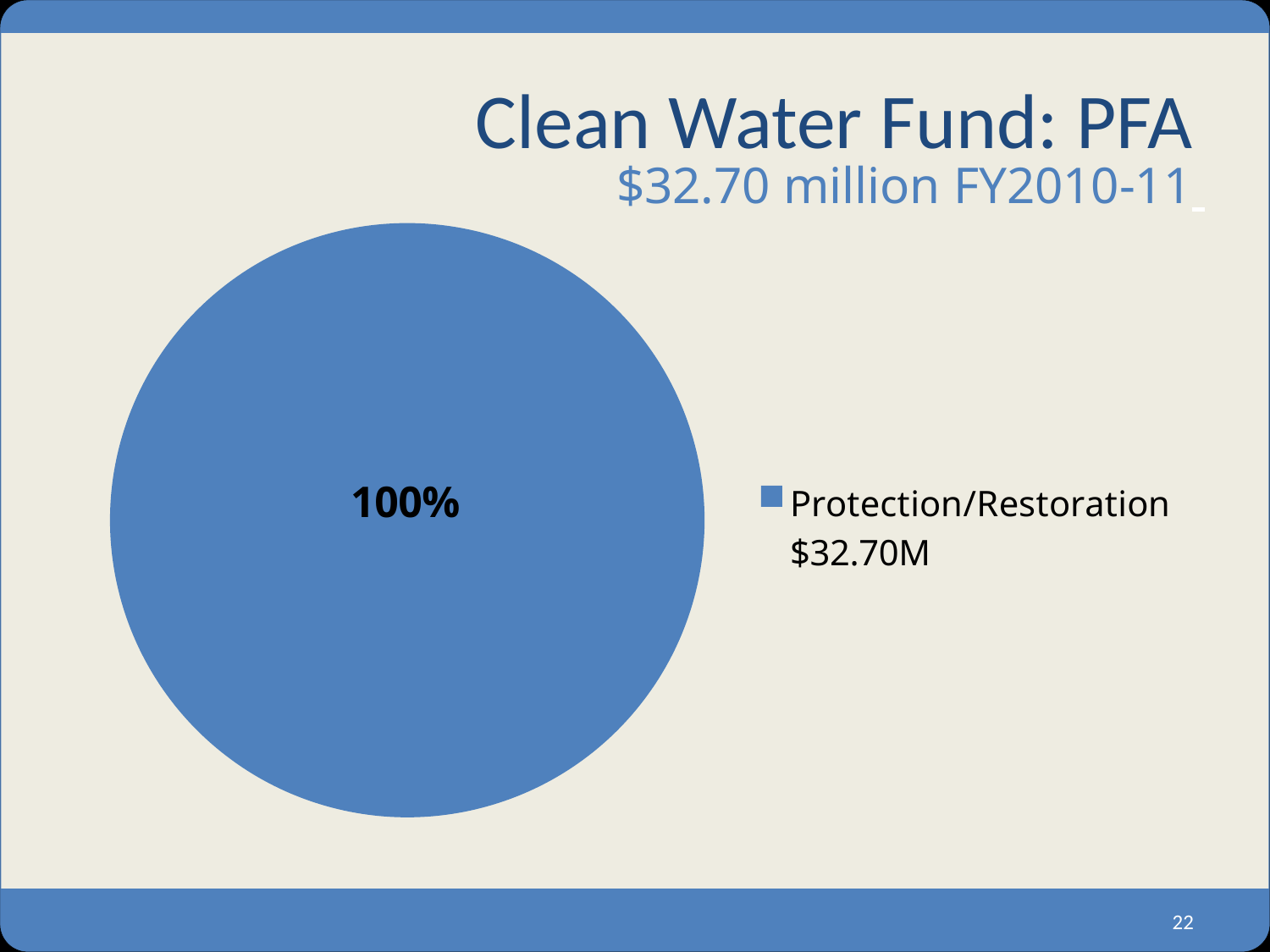
What share of the pie does Protection/Restoration represent? 100% Which category makes up the entire pie? Protection/Restoration How many slices does the pie chart have? 1 What dollar amount is listed in the legend for Protection/Restoration? $32.70M What kind of chart is shown on the slide? pie chart What is the title of the chart? Clean Water Fund: PFA What total amount and fiscal year are given in the chart subtitle? $32.70 million FY2010-11 How many entries does the legend list? 1